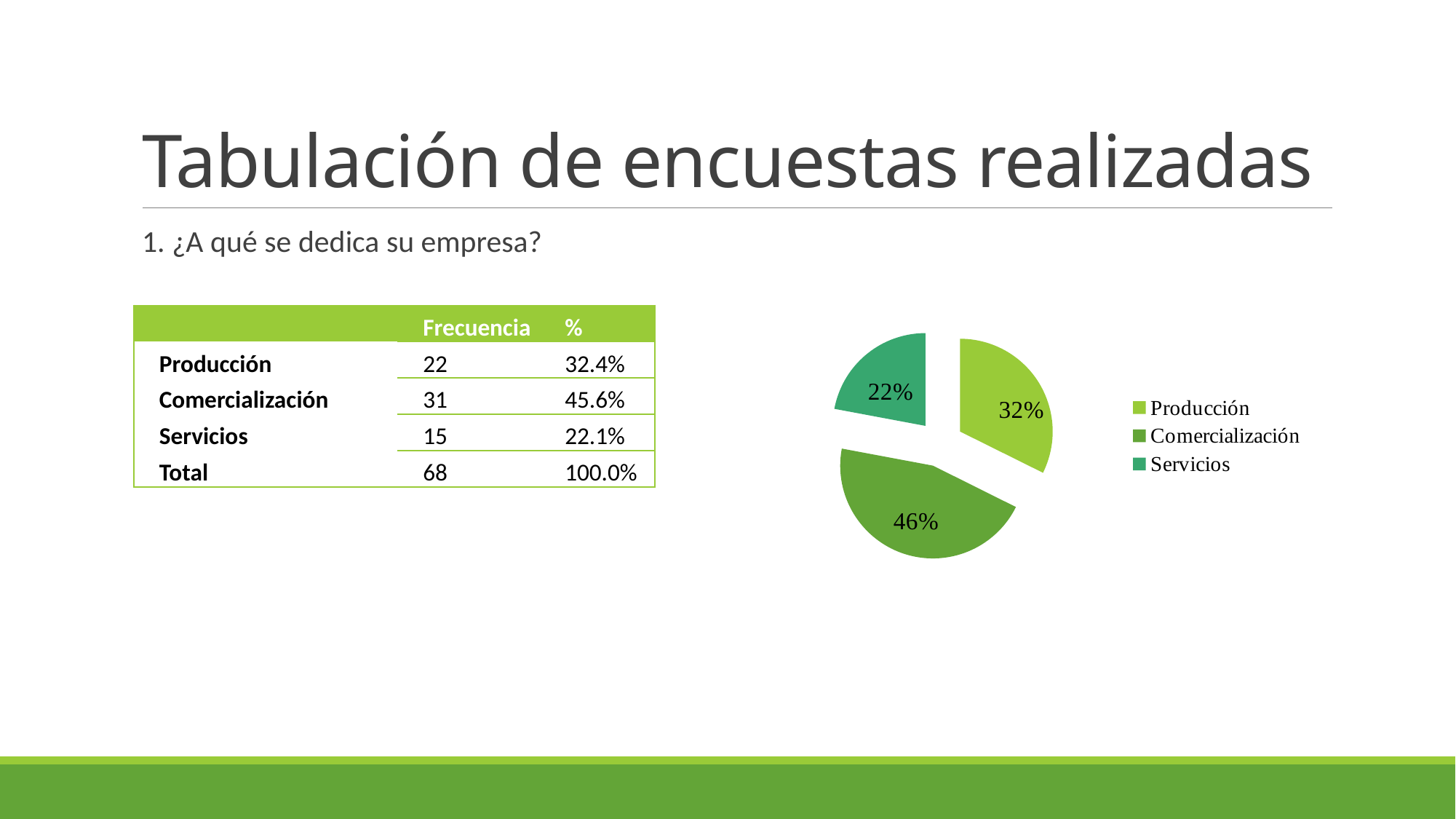
Which category has the smallest slice in the pie chart? Servicios Which category has the largest slice in the pie chart? Comercialización What kind of chart is shown on the slide? pie chart By how many percentage points does the Producción slice exceed the Servicios slice in the pie chart? 10% How many entries does the pie chart legend list? 3 Which slice is larger in the pie chart, Producción or Servicios? Producción How many slices does the pie chart have? 3 What percentage does the pie chart show for Comercialización? 46% By how many percentage points does the Comercialización slice exceed the Producción slice in the pie chart? 14% What percentage does the pie chart show for Producción? 32% What percentage does the pie chart show for Servicios? 22% Which legend entry in the pie chart is shown in the lightest green? Producción